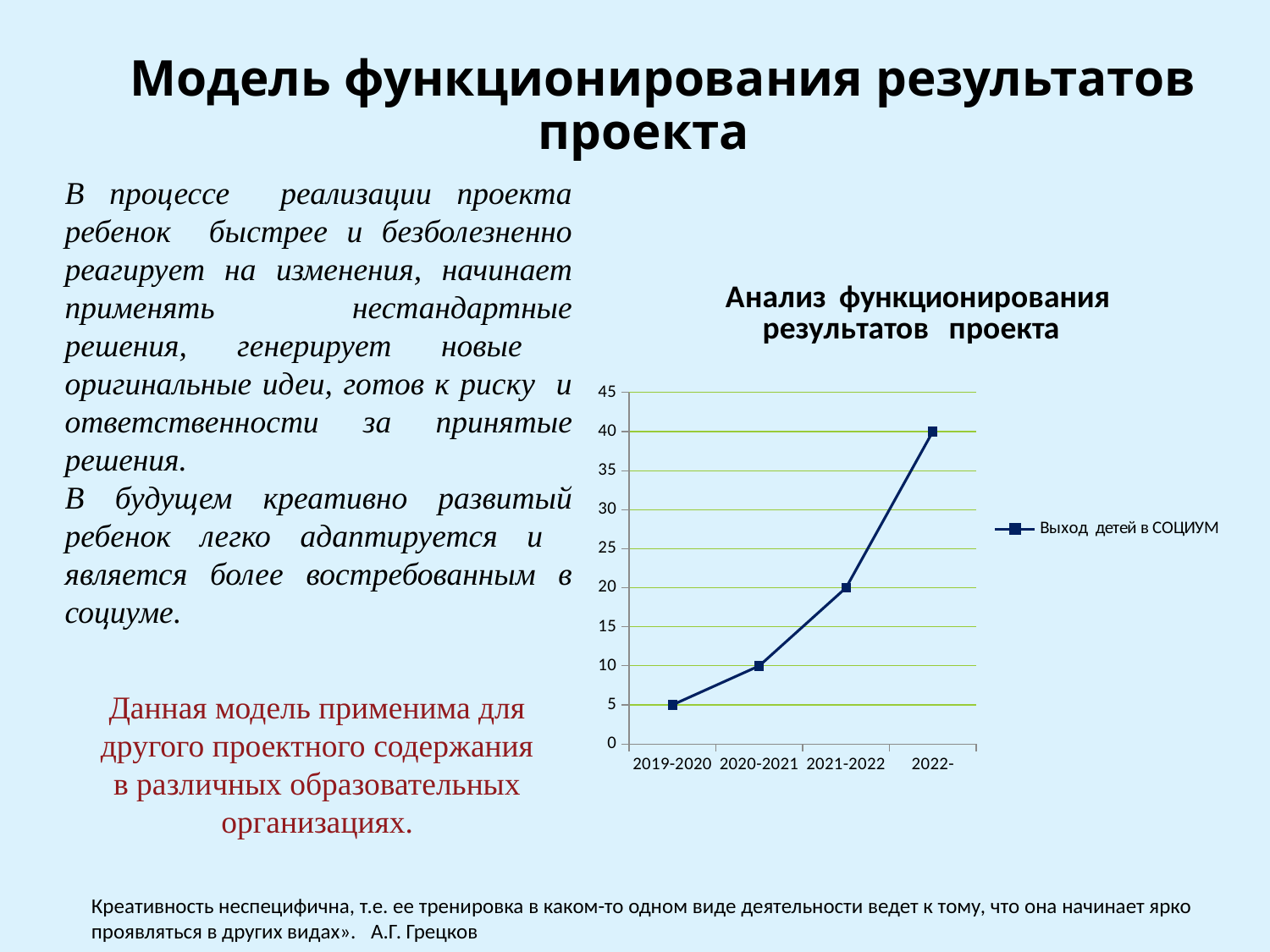
How many data points are plotted on the line? 4 What is the title of the chart? Анализ функционирования результатов проекта What series does the chart legend list? Выход детей в СОЦИУМ Which period has the highest value? 2022- Which period has the lowest value? 2019-2020 What is the value for 2019-2020? 5 What is the value for 2020-2021? 10 What is the value for 2021-2022? 20 Is the value for 2022- greater or less than 35? greater Do the values rise or fall from 2019-2020 to 2022-? rise What kind of chart is shown on the slide? line chart How many series does the legend list? 1